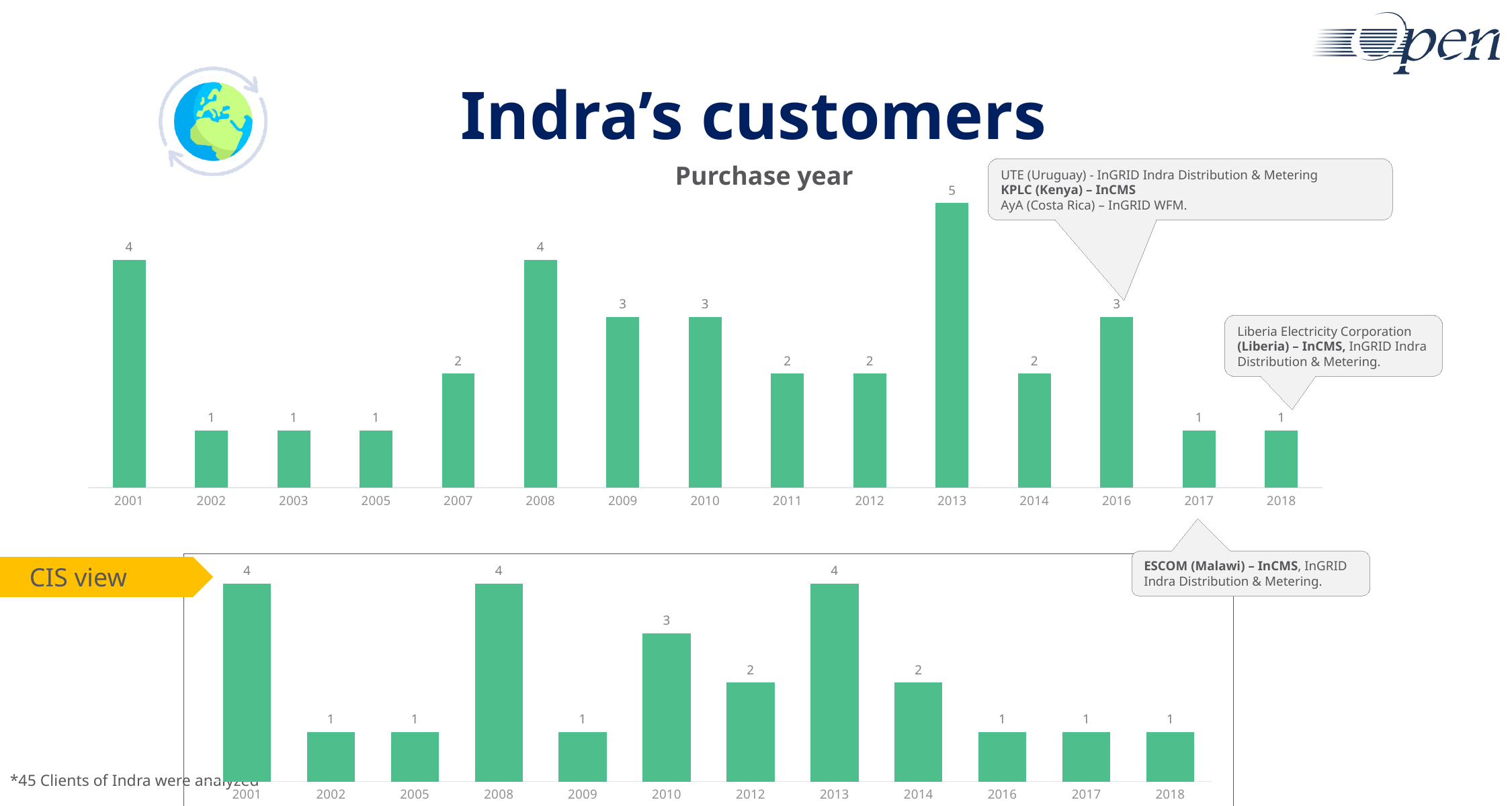
In the top 'Purchase year' chart, which year has the highest value? 2013 In the top 'Purchase year' chart, which is larger, the value for 2009 or the value for 2011? 2009 In the bottom 'CIS view' chart, what is the value for 2010? 3 In the top 'Purchase year' chart, what is the difference between the values for 2013 and 2008? 1 In the top 'Purchase year' chart, what is the value for 2016? 3 In the top 'Purchase year' chart, how many years are shown on the x axis? 15 What is the title of the top chart? Purchase year In the bottom 'CIS view' chart, how many years are shown on the x axis? 12 In the top 'Purchase year' chart, what is the value for 2013? 5 In the bottom 'CIS view' chart, which is larger, the value for 2014 or the value for 2016? 2014 What kind of chart is the top 'Purchase year' chart? bar chart In the bottom 'CIS view' chart, what is the difference between the values for 2008 and 2012? 2